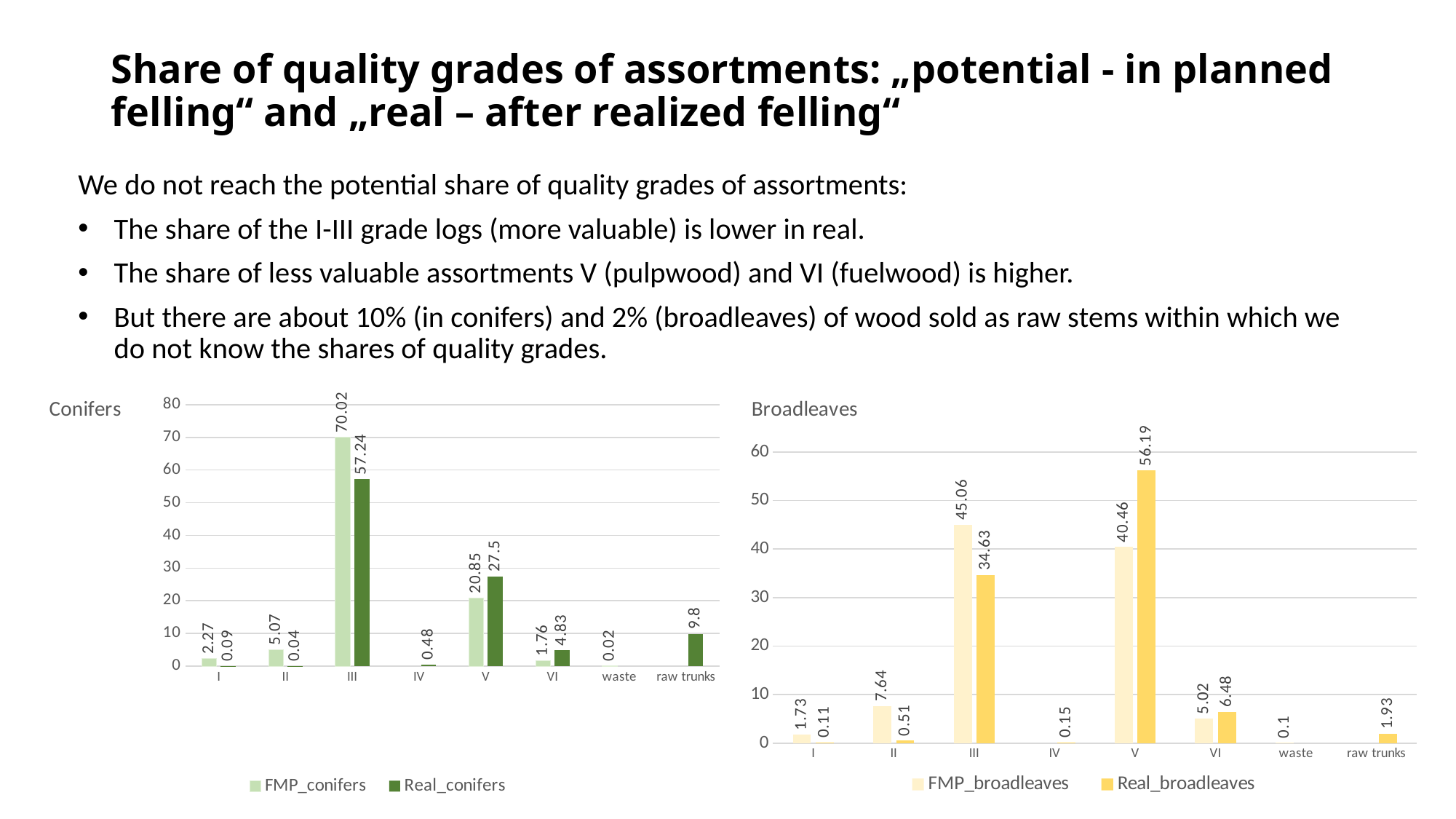
How many categories are shown on the x axis of the Broadleaves chart? 8 In the Conifers chart, what is the FMP_conifers value for grade III? 70.02 In the Conifers chart, what is the difference between the FMP_conifers and Real_conifers values for grade III? 12.78 In the Broadleaves chart, what is the FMP_broadleaves value for grade II? 7.64 How many series does the legend of the Conifers chart list? 2 What type of chart is the Broadleaves chart? Bar chart In the Broadleaves chart, which category has the highest FMP_broadleaves value? III In the Broadleaves chart, what is the difference between the Real_broadleaves and FMP_broadleaves values for grade V? 15.73 In the Conifers chart, what is the Real_conifers value for raw trunks? 9.8 In the Conifers chart, which is larger for grade V: FMP_conifers or Real_conifers? Real_conifers In the Broadleaves chart, what is the Real_broadleaves value for grade V? 56.19 In the Conifers chart, which category has the highest Real_conifers value? III